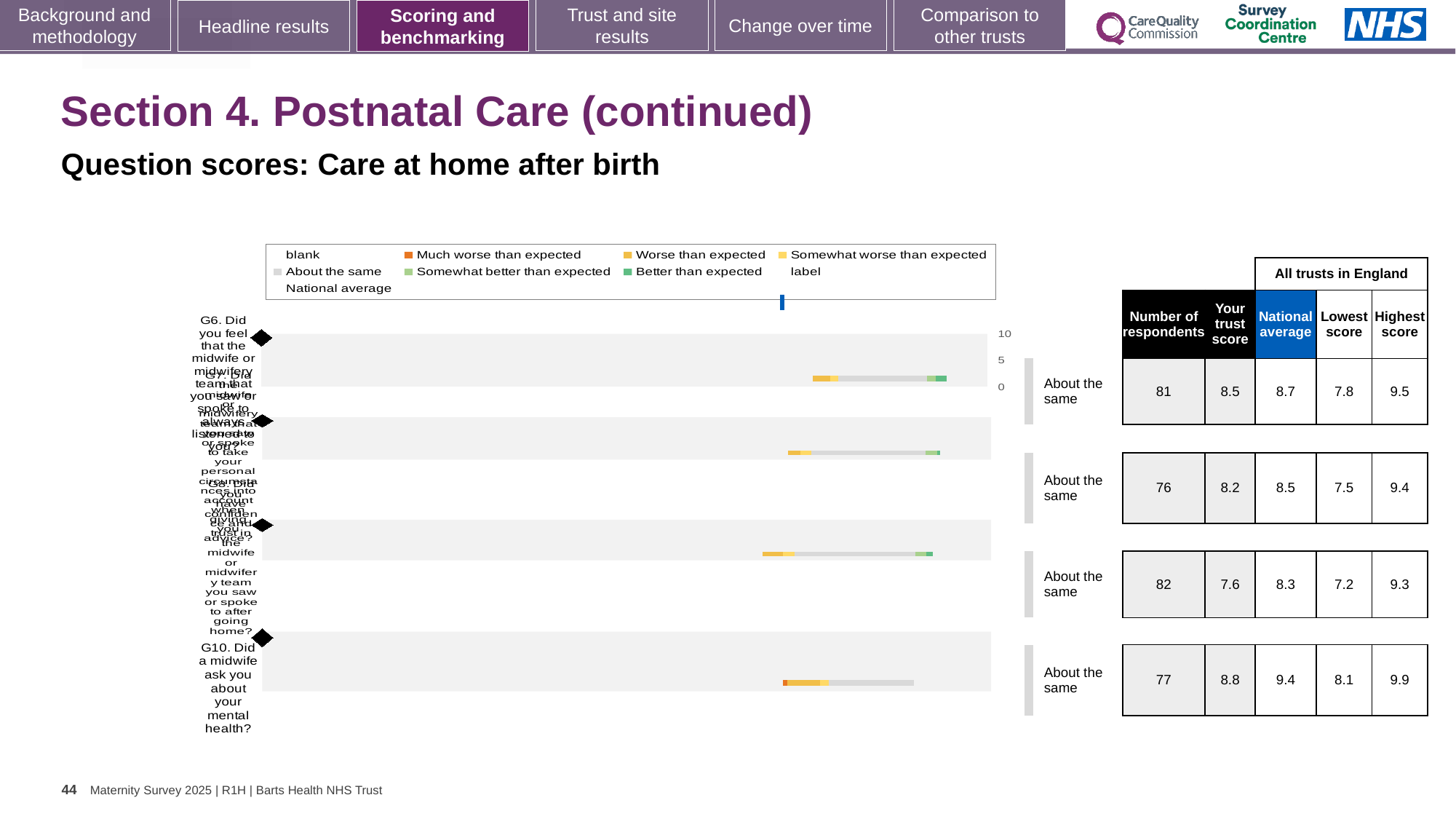
What is the lowest 'Your trust score' value shown in the table? 7.6 What is the national average for G10 (Did a midwife ask you about your mental health?)? 9.4 What is the lowest score across all trusts in England for G10 (Did a midwife ask you about your mental health?)? 8.1 Which question has the highest 'Your trust score' in the table? G10. Did a midwife ask you about your mental health? For G10, which is larger: the trust score or the national average? National average What is the highest score across all trusts in England for G10 (Did a midwife ask you about your mental health?)? 9.9 For G10, what is the difference between the national average and the trust score? 0.6 What benchmark category is shown next to each of the four bars? About the same How many questions (bars) are plotted in the chart? 4 How many respondents are listed for G10 (Did a midwife ask you about your mental health?)? 77 What kind of chart is used to show the question scores on this slide? Bar chart What is the 'Your trust score' for G10 (Did a midwife ask you about your mental health?)? 8.8